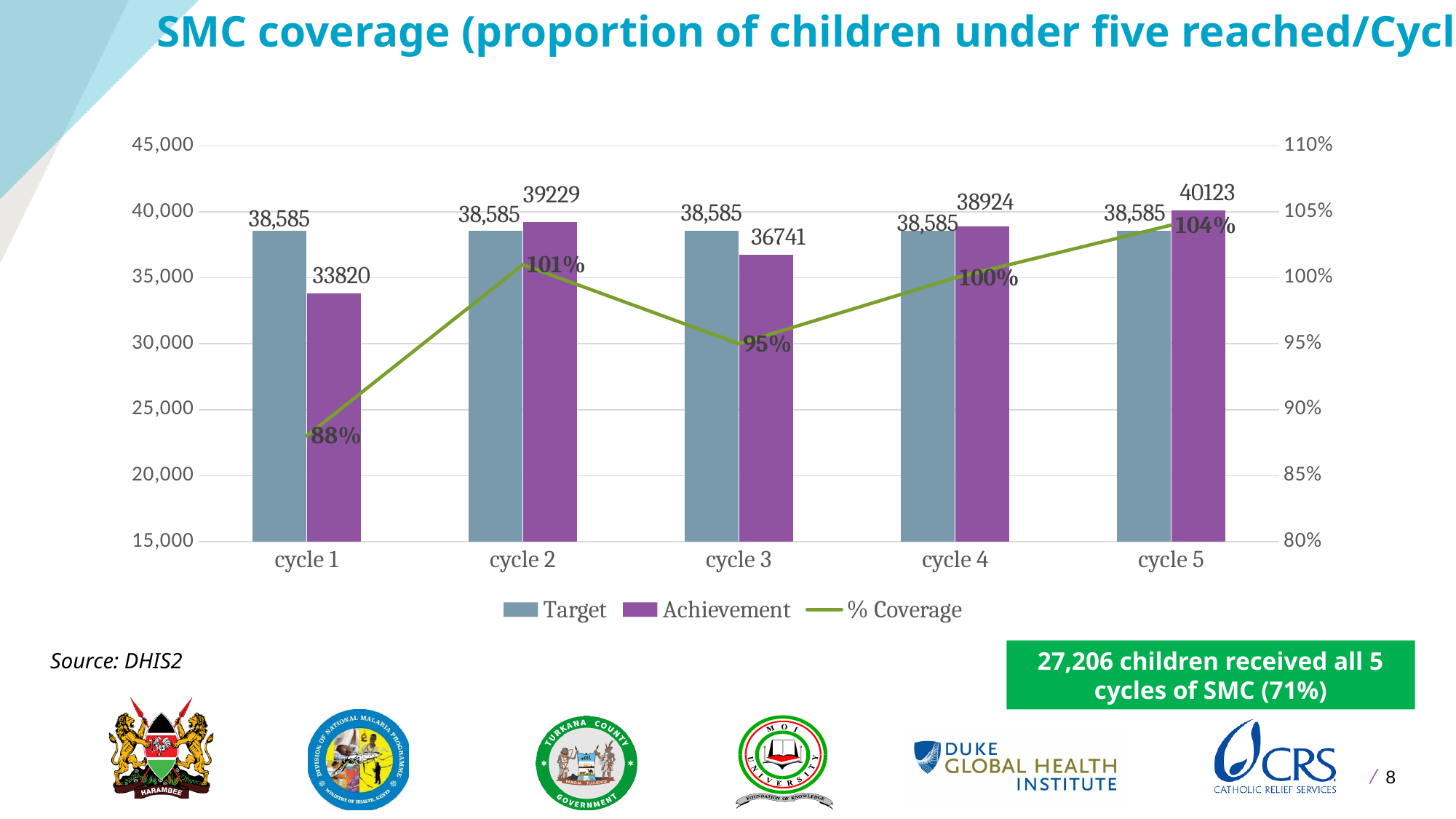
What is the % Coverage for cycle 3? 95% How many series does the legend list? 3 Which is larger for cycle 3, the Target or the Achievement? Target Which cycle has the lowest % Coverage? cycle 1 Does the % Coverage rise or fall from cycle 3 to cycle 5? rise Which series is plotted as a line rather than bars? % Coverage What is the Achievement value for cycle 1? 33820 How many cycles are shown on the x axis? 5 What is the Target value for cycle 4? 38,585 Is the Achievement value for cycle 2 greater or less than 35,000? greater Which cycle has the highest Achievement value? cycle 5 What is the difference between the Achievement values for cycle 5 and cycle 1? 6303